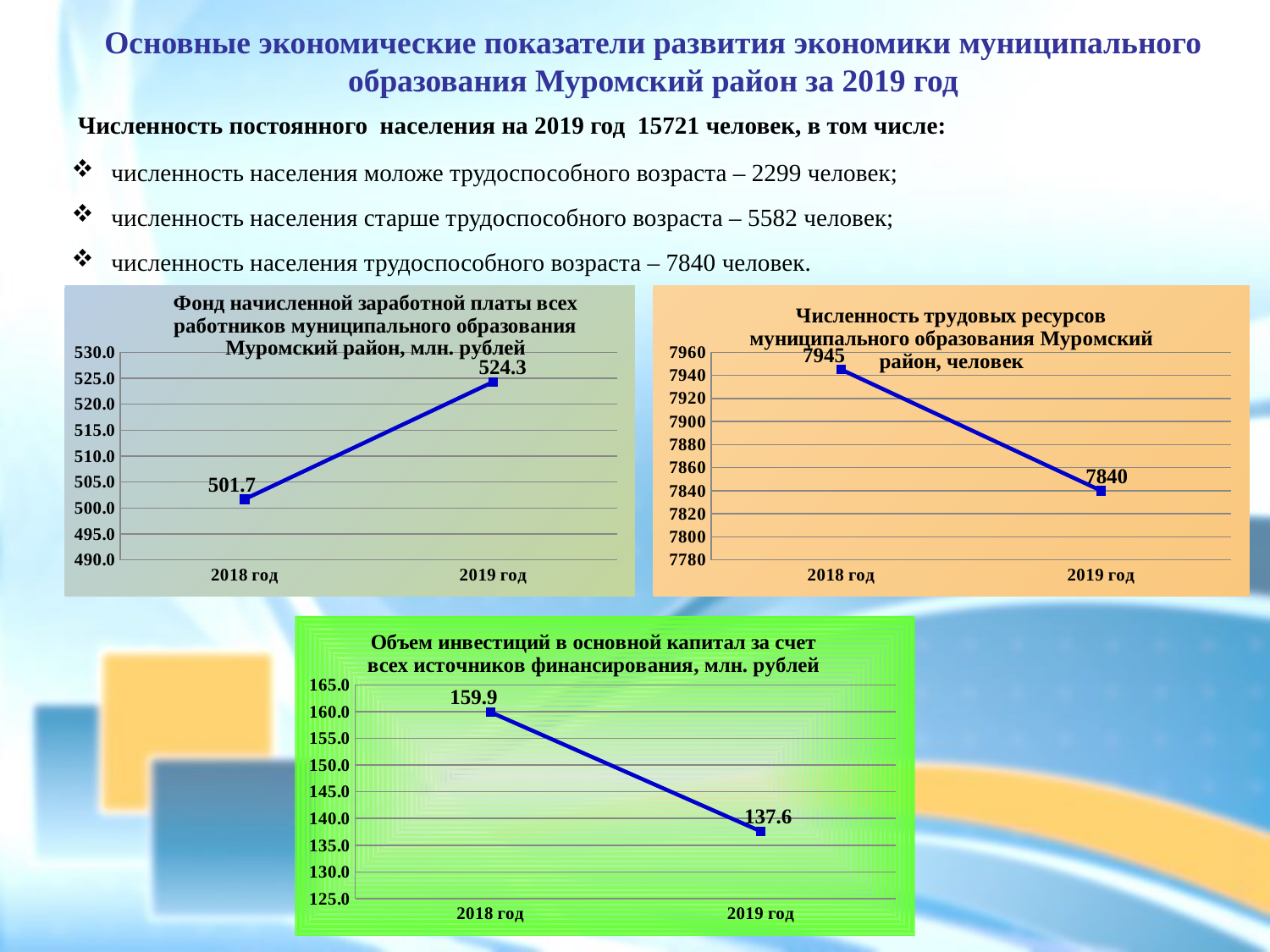
In the chart 'Фонд начисленной заработной платы всех работников муниципального образования Муромский район, млн. рублей', what is the value for 2018 год? 501.7 In the chart 'Численность трудовых ресурсов муниципального образования Муромский район, человек', which year has the lower value? 2019 год In the chart 'Численность трудовых ресурсов муниципального образования Муромский район, человек', what is the difference between the 2018 год and 2019 год values? 105 In the chart 'Численность трудовых ресурсов муниципального образования Муромский район, человек', what is the value for 2019 год? 7840 What kind of chart is 'Объем инвестиций в основной капитал за счет всех источников финансирования, млн. рублей'? line chart In the chart 'Фонд начисленной заработной платы всех работников муниципального образования Муромский район, млн. рублей', by how much did the value change from 2018 год to 2019 год? 22.6 In the chart 'Численность трудовых ресурсов муниципального образования Муромский район, человек', what is the value for 2018 год? 7945 In the chart 'Объем инвестиций в основной капитал за счет всех источников финансирования, млн. рублей', what is the value for 2019 год? 137.6 In the chart 'Фонд начисленной заработной платы всех работников муниципального образования Муромский район, млн. рублей', what is the value for 2019 год? 524.3 In the chart 'Объем инвестиций в основной капитал за счет всех источников финансирования, млн. рублей', do the values rise or fall from 2018 год to 2019 год? fall In the chart 'Объем инвестиций в основной капитал за счет всех источников финансирования, млн. рублей', what is the value for 2018 год? 159.9 In the chart 'Фонд начисленной заработной платы всех работников муниципального образования Муромский район, млн. рублей', do the values rise or fall from 2018 год to 2019 год? rise